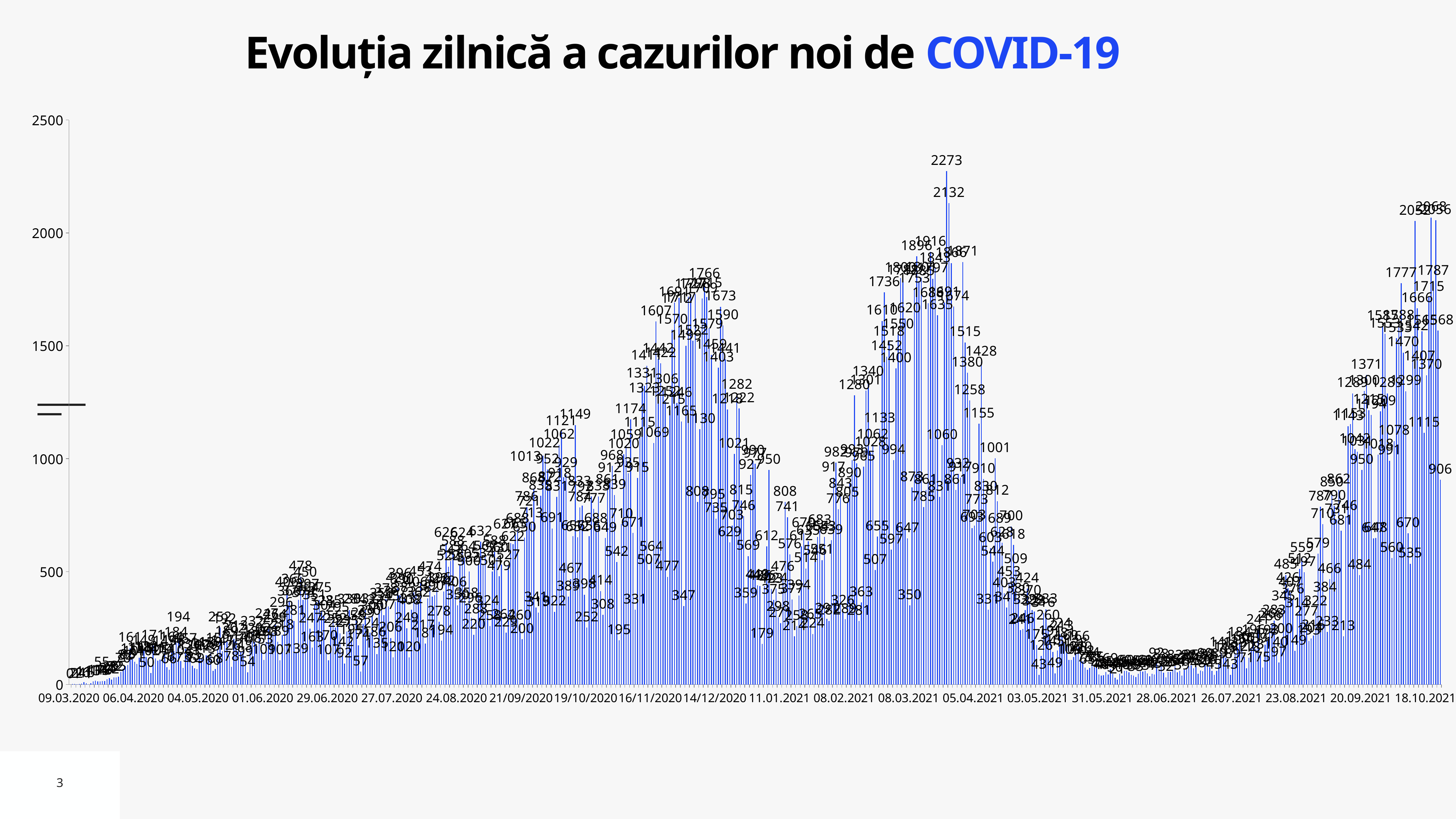
Is the highest value on the chart greater or less than 2000? greater Which is larger: the peak value of 2273 (around 05.04.2021) or the peak value of 1766 (around 14.12.2020)? 2273 What is the highest tick value shown on the vertical axis? 2500 What is the difference between the two highest labelled values, 2273 and 2132? 141 What is the second-highest value labelled on the chart, next to the 2273 peak? 2132 Are the daily values around 28.06.2021 greater or less than 500? less What is the title of the chart? Evoluția zilnică a cazurilor noi de COVID-19 Do the values rise or fall between 05.04.2021 and 31.05.2021? fall What is the difference between the peak value 2273 and the peak value 1766? 507 What is the highest daily value labelled on the chart? 2273 Do the values rise or fall between 26.07.2021 and 18.10.2021? rise What kind of chart is shown on the slide? bar chart